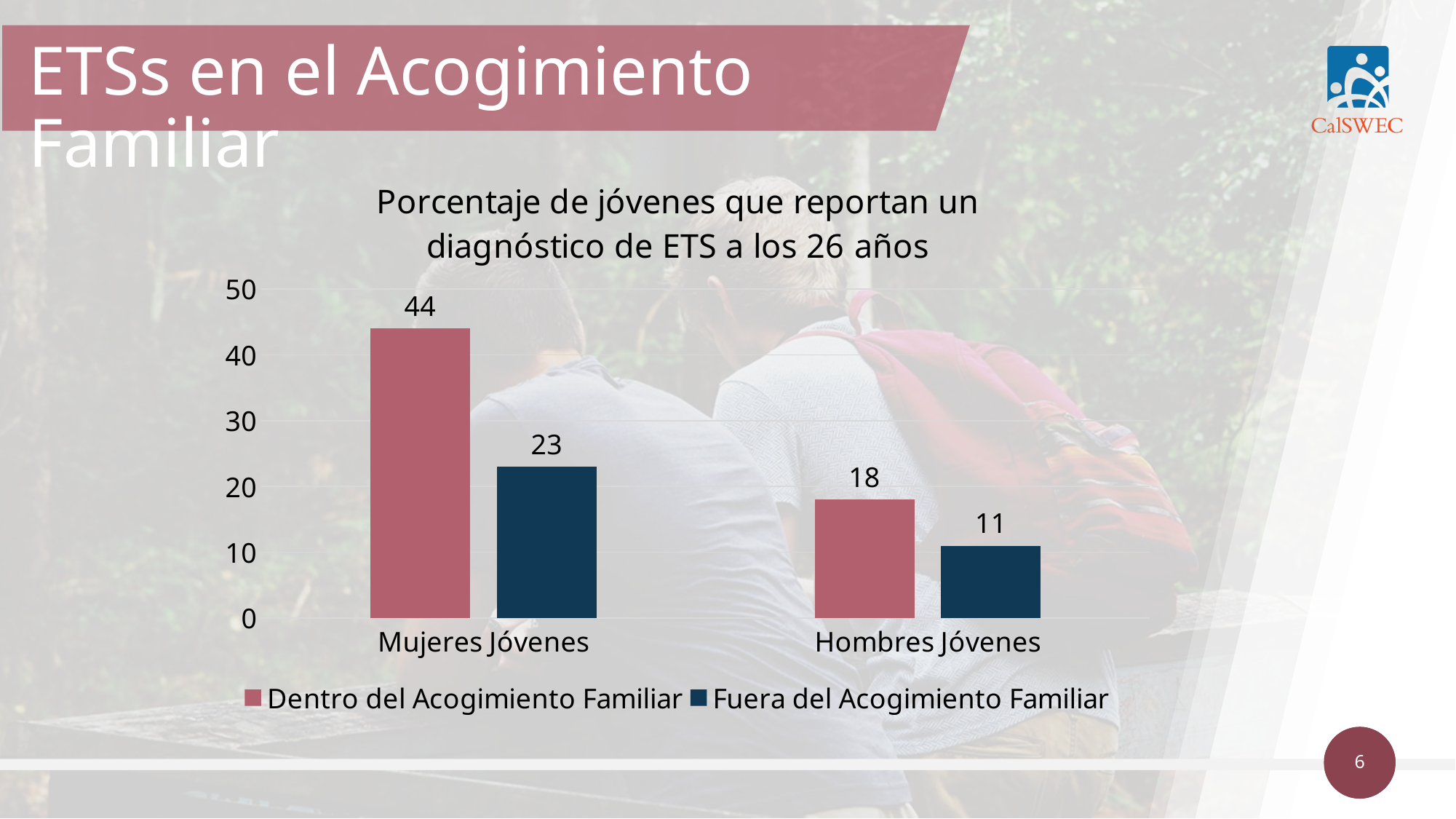
What is the difference between the Dentro and Fuera del Acogimiento Familiar values for Hombres Jóvenes? 7 Which category has the lowest value in the Fuera del Acogimiento Familiar series? Hombres Jóvenes What is the value for Hombres Jóvenes in the Dentro del Acogimiento Familiar series? 18 What is the value for Mujeres Jóvenes in the Fuera del Acogimiento Familiar series? 23 What is the difference between the Dentro and Fuera del Acogimiento Familiar values for Mujeres Jóvenes? 21 How many categories are shown on the x axis? 2 What kind of chart is shown on the slide? Bar chart What is the value for Hombres Jóvenes in the Fuera del Acogimiento Familiar series? 11 How many series does the legend list? 2 What is the value for Mujeres Jóvenes in the Dentro del Acogimiento Familiar series? 44 Which category has the highest value in the Dentro del Acogimiento Familiar series? Mujeres Jóvenes Which is larger: the Fuera del Acogimiento Familiar value for Mujeres Jóvenes or the Dentro del Acogimiento Familiar value for Hombres Jóvenes? Fuera del Acogimiento Familiar value for Mujeres Jóvenes